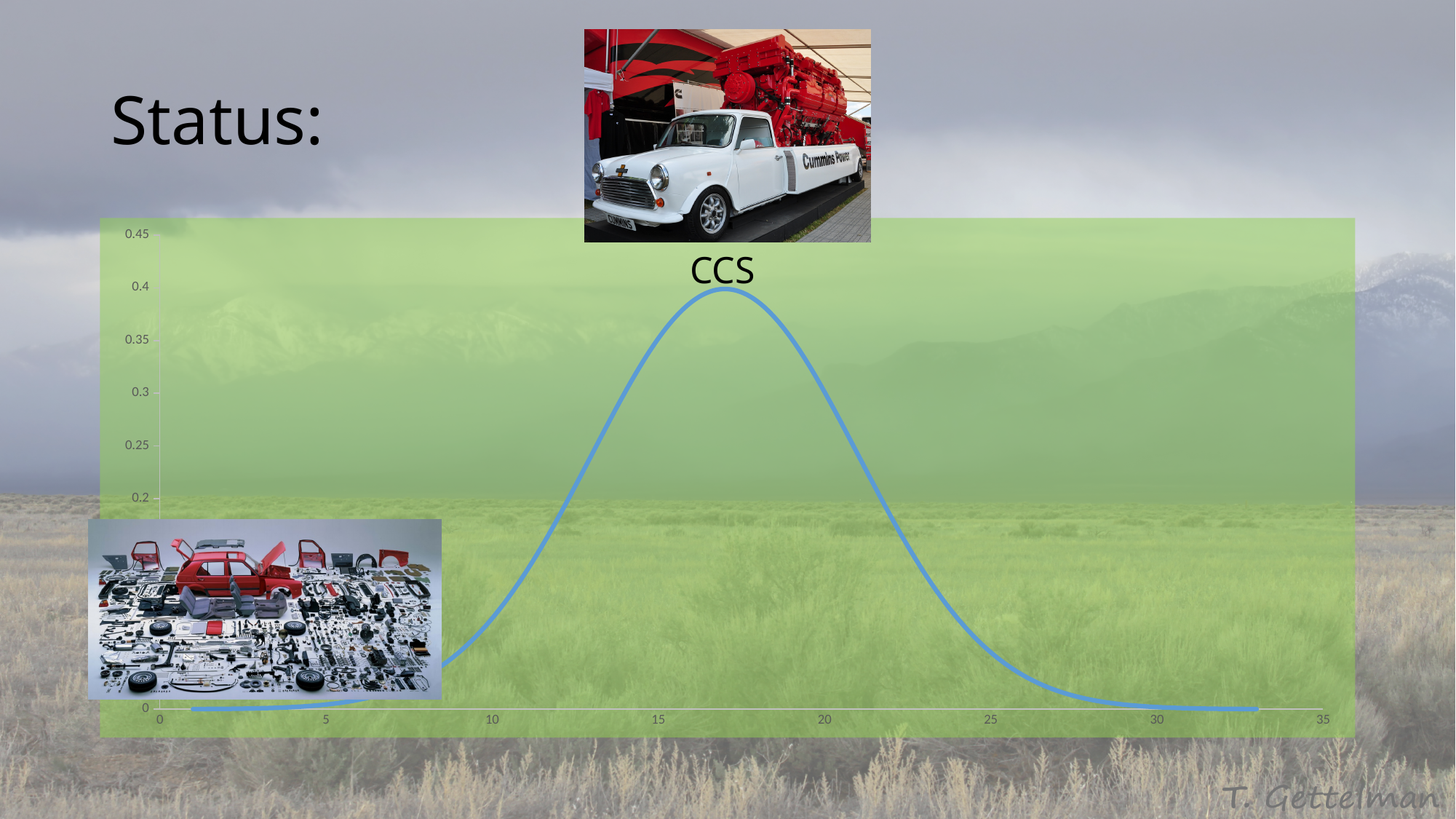
What is the highest tick value shown on the vertical axis? 0.45 What kind of chart is shown on the slide? line chart Is the value of the curve at x = 25 greater or less than 0.2? less Is the peak value of the curve greater or less than 0.35? greater Does the curve rise or fall as x increases from 20 to 30? fall How many lines (series) are plotted on the chart? 1 Does the curve rise or fall as x increases from 5 to 15? rise Is the value of the curve at x = 20 greater or less than 0.2? greater What text label is placed above the peak of the curve? CCS